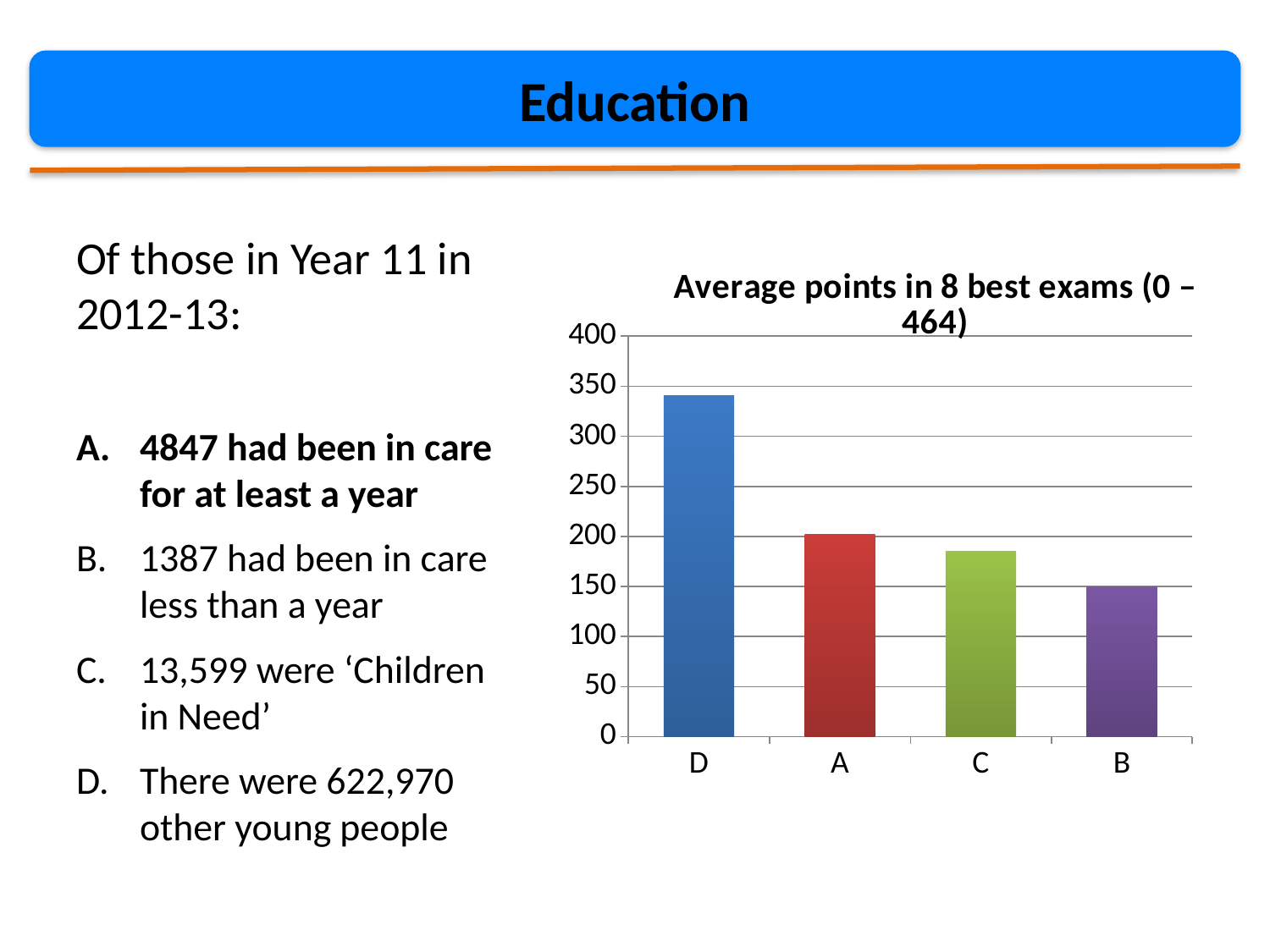
Is the value for C greater or less than 200? less Which has a higher value in the chart, A or B? A Is the value for D greater or less than 350? less Which category has the lowest average points in the chart? B What is the title of the chart? Average points in 8 best exams (0 – 464) Is the value for D greater or less than 300? greater Which category has the highest average points in the chart? D How many categories are shown on the x axis of the chart? 4 Which has a higher value in the chart, D or A? D What kind of chart is shown on the slide? bar chart Do the values rise or fall from left to right along the x axis? fall